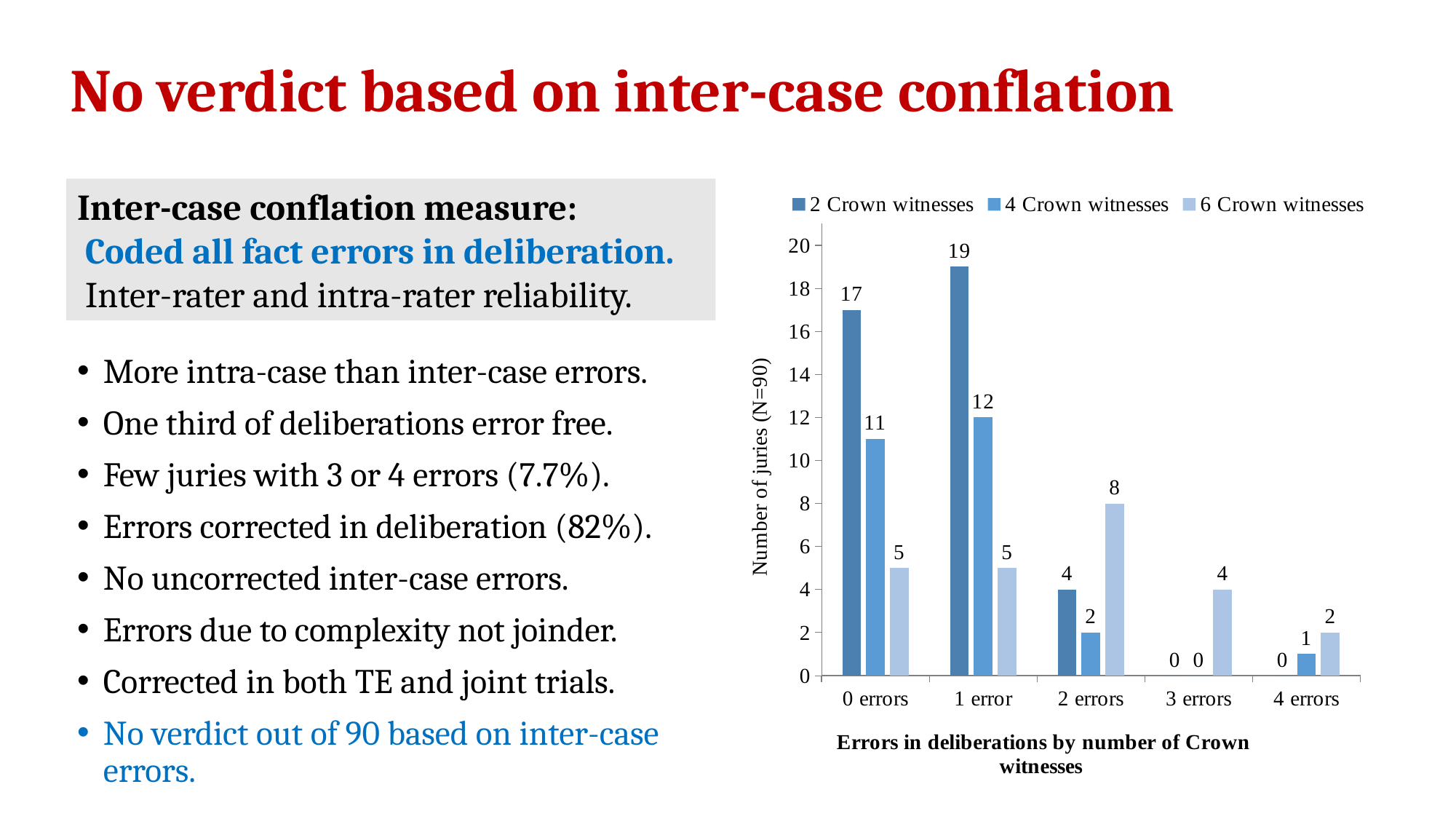
How many series does the legend list? 3 What is the y-axis label of the chart? Number of juries (N=90) Which error category has the highest value for 2 Crown witnesses? 1 error For 2 errors, which is larger: the value for 4 Crown witnesses or 6 Crown witnesses? 6 Crown witnesses How many juries with 2 Crown witnesses had 0 errors? 17 Is the value for 2 Crown witnesses at 1 error greater or less than 18? greater How many juries with 4 Crown witnesses had 1 error? 12 How many error categories are shown on the x axis? 5 What kind of chart is shown on the slide? bar chart What is the difference between the 2 Crown witnesses and 4 Crown witnesses values for 0 errors? 6 Which error category has the lowest value for 6 Crown witnesses? 4 errors How many juries with 6 Crown witnesses had 2 errors? 8